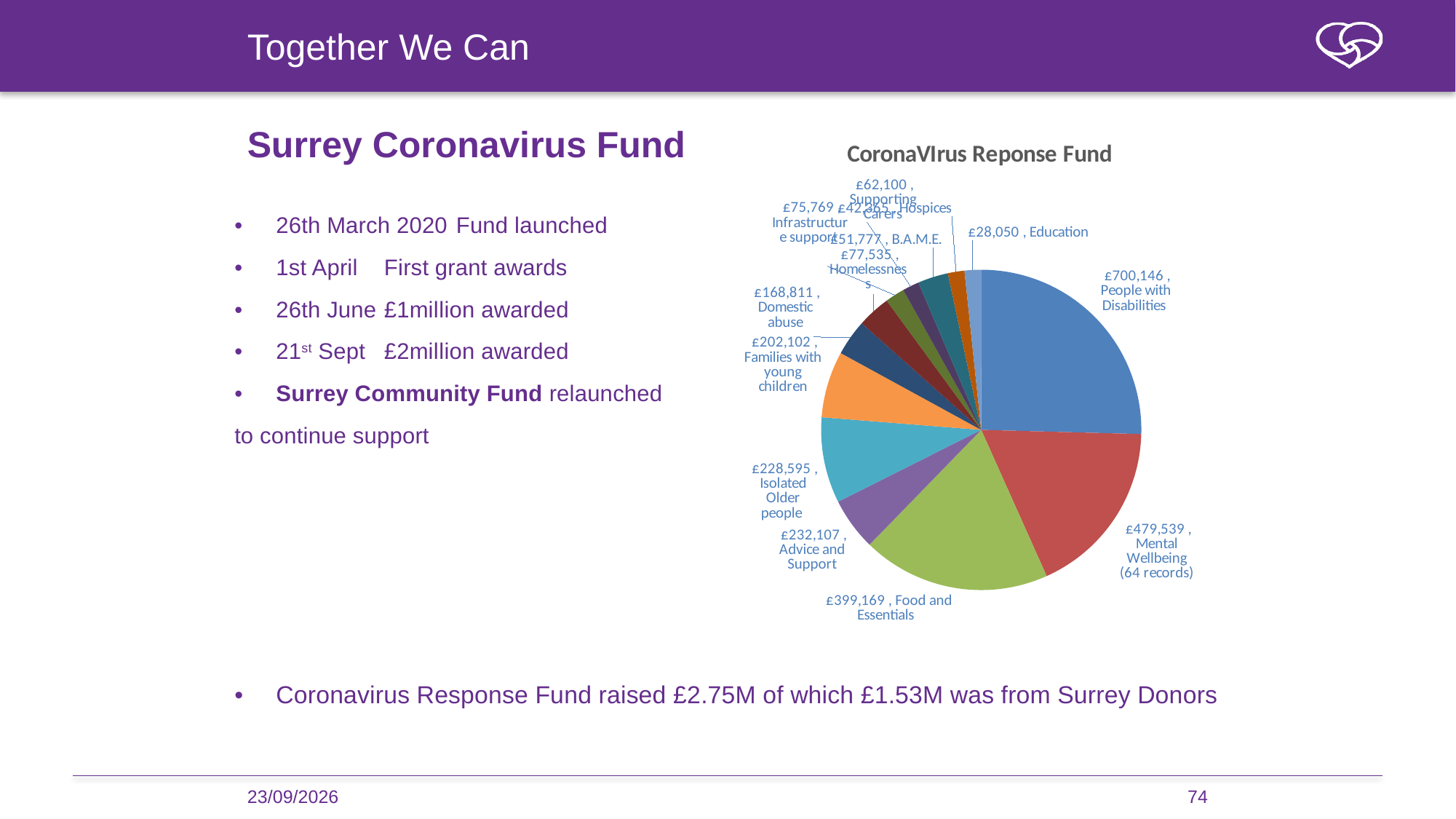
What amount is shown for Domestic abuse? £168,811 What amount is shown for Education? £28,050 What amount is shown for People with Disabilities? £700,146 What is the title of the chart? CoronaVIrus Reponse Fund Which received more funding, Advice and Support or Isolated Older people? Advice and Support What kind of chart is shown on the slide? pie chart How many slices does the pie chart have? 13 How much larger is the amount for People with Disabilities than for Mental Wellbeing? £220,607 Which category has the smallest slice of the pie? Education What is the difference between the amounts for Food and Essentials and Families with young children? £197,067 What amount is shown for Food and Essentials? £399,169 Which category has the largest slice of the pie? People with Disabilities